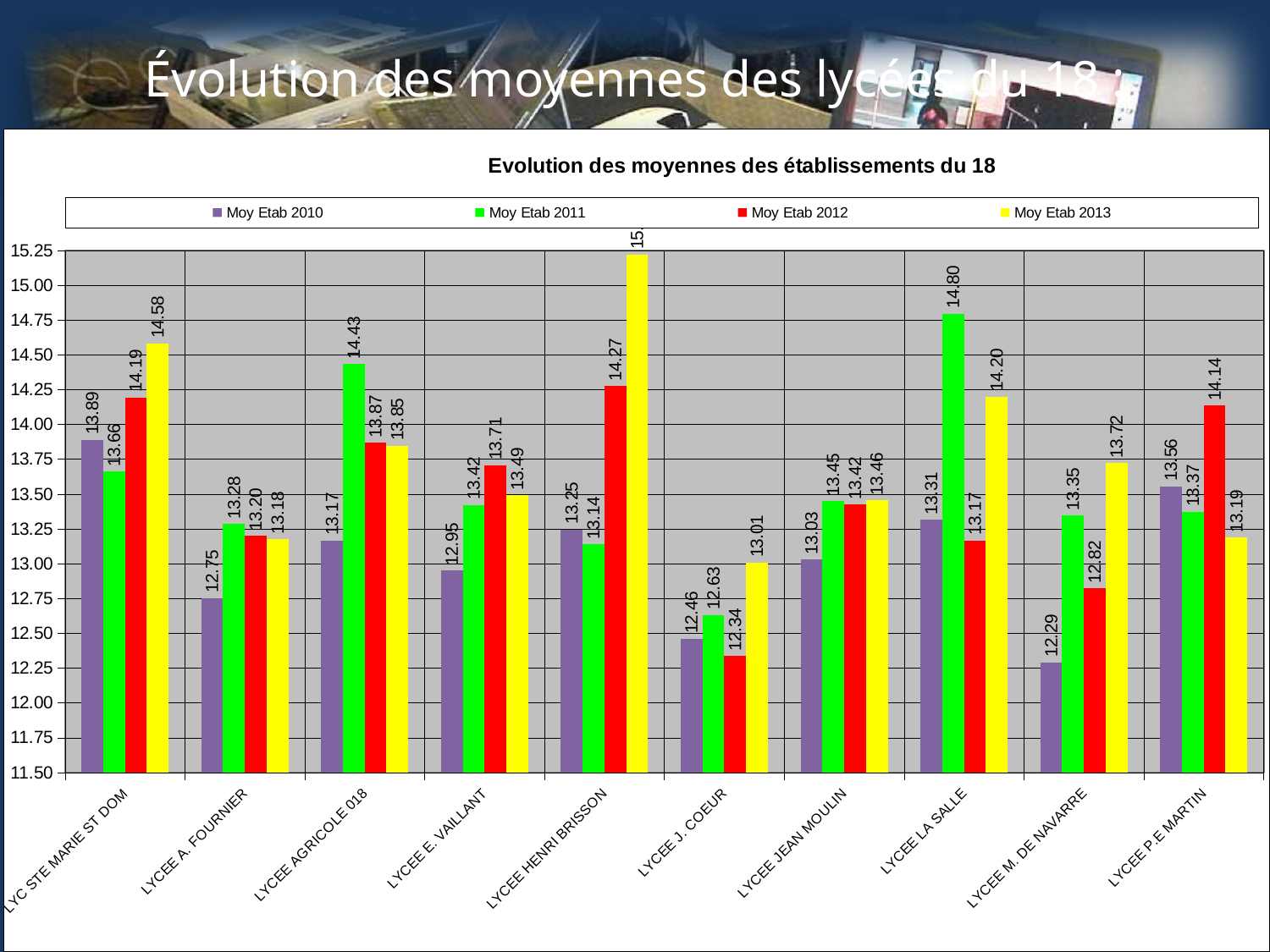
For LYCEE P.E MARTIN, which is larger: Moy Etab 2012 or Moy Etab 2013? Moy Etab 2012 How many series does the legend list? 4 Is the Moy Etab 2013 value for LYCEE HENRI BRISSON greater or less than 15.00? greater How many lycées are shown on the x axis of the chart? 10 Which lycée has the highest Moy Etab 2011 value? LYCEE LA SALLE What is the Moy Etab 2012 value for LYCEE E. VAILLANT? 13.71 What is the title of the chart? Evolution des moyennes des établissements du 18 What is the Moy Etab 2010 value for LYCEE J. COEUR? 12.46 What is the difference between the Moy Etab 2011 and Moy Etab 2010 values for LYCEE AGRICOLE 018? 1.26 What is the Moy Etab 2013 value for LYCEE LA SALLE? 14.20 What kind of chart is shown on the slide? bar chart Which lycée has the lowest Moy Etab 2010 value? LYCEE M. DE NAVARRE